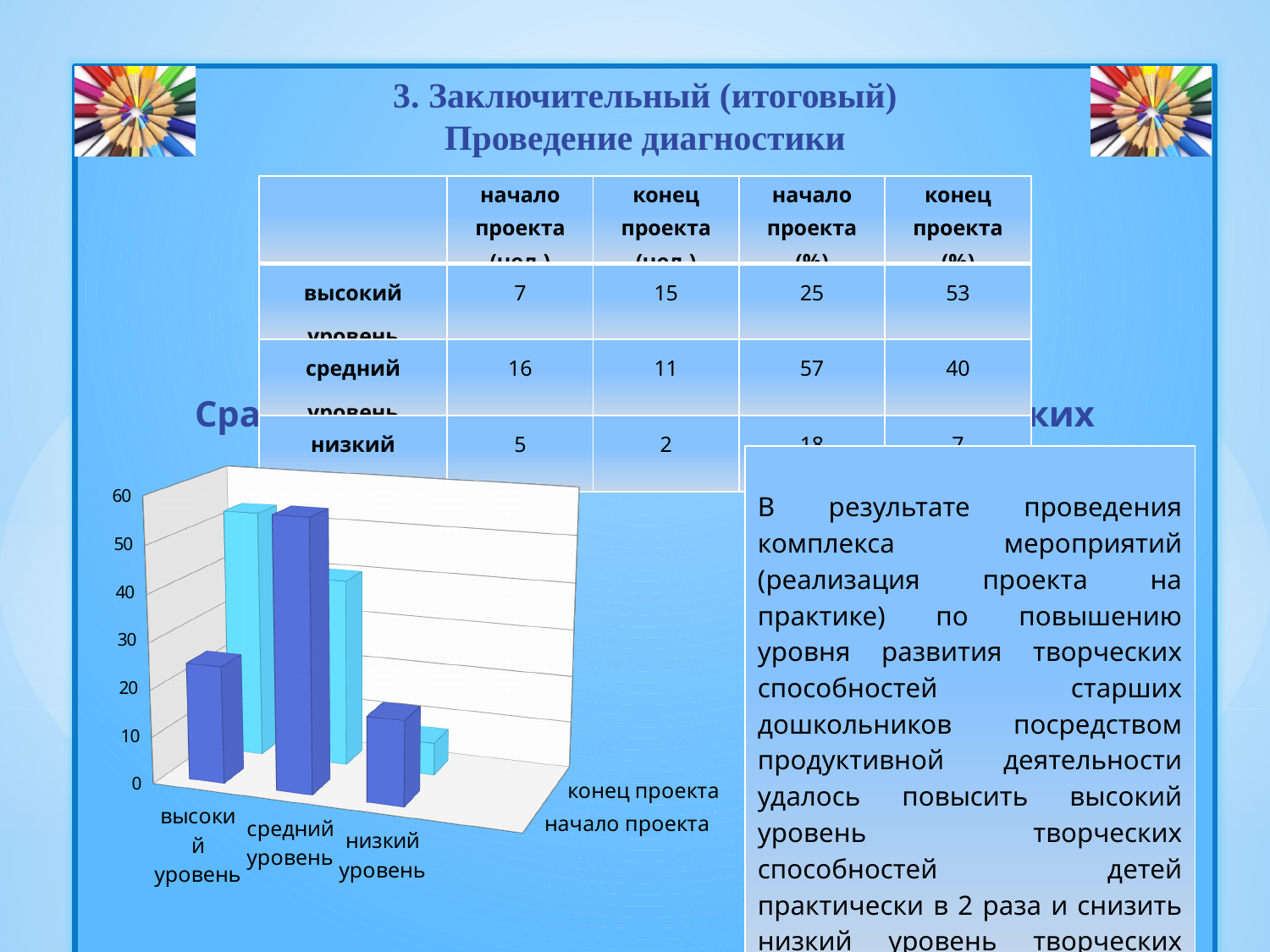
Which category has the tallest bar for начало проекта? средний уровень How many series does the chart show (начало проекта and конец проекта)? 2 For высокий уровень, which is larger: начало проекта or конец проекта? конец проекта Is the value for высокий уровень at начало проекта greater or less than 30? less Is the value for средний уровень at начало проекта greater or less than 50? greater Which category has the tallest bar for конец проекта? высокий уровень Which category has the shortest bar for конец проекта? низкий уровень How many level categories are shown along the x axis of the chart? 3 For средний уровень, which is larger: начало проекта or конец проекта? начало проекта Do the конец проекта values rise or fall going from высокий уровень to низкий уровень? fall What is the highest tick value shown on the vertical axis of the chart? 60 What kind of chart is shown on the slide? bar chart